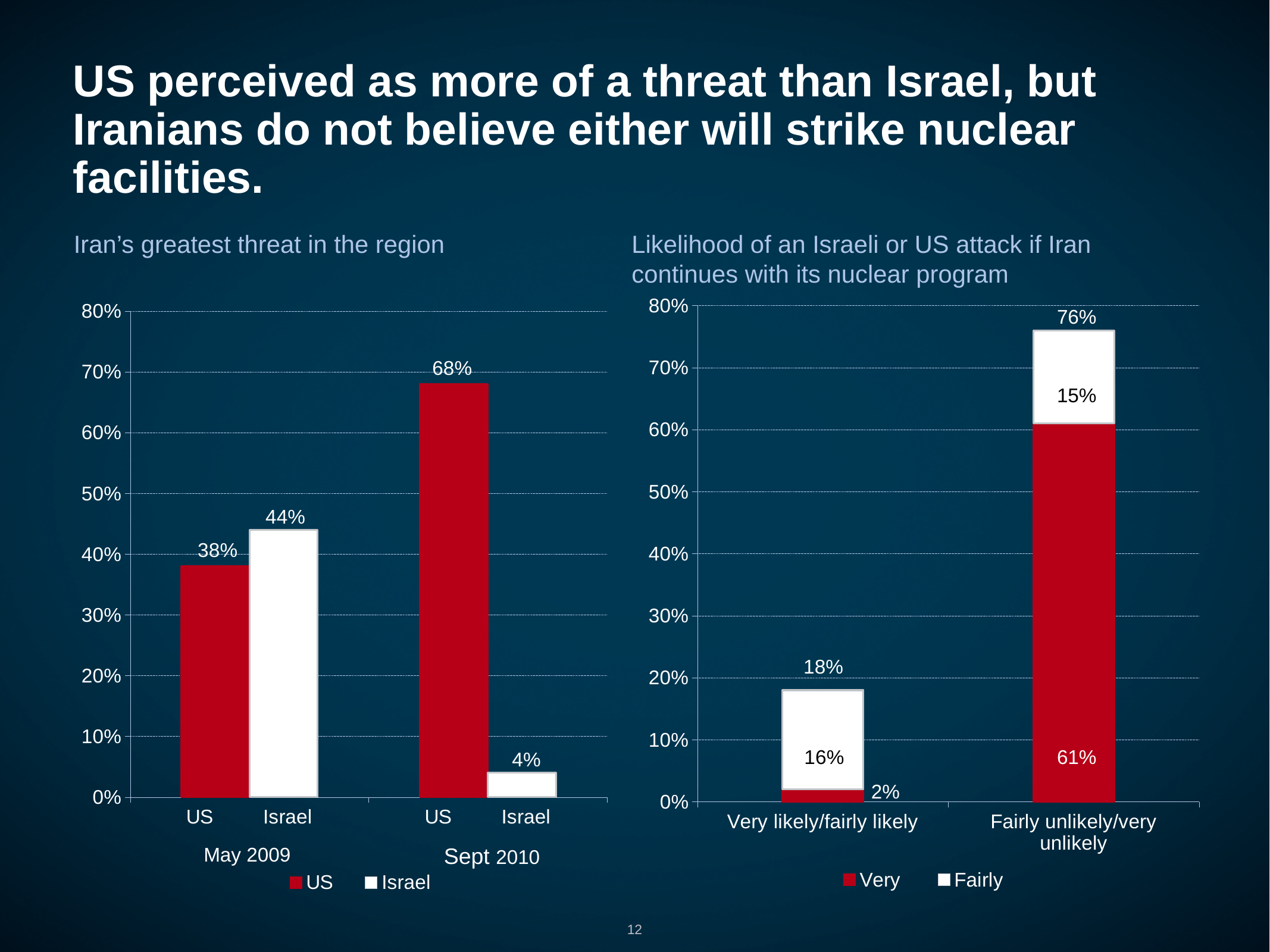
In the 'Likelihood of an Israeli or US attack' chart, what is the total of the 'Fairly unlikely/very unlikely' stacked bar? 76% In the 'Iran's greatest threat in the region' chart, what is the difference between the US value in Sept 2010 and the US value in May 2009? 30% In the 'Likelihood of an Israeli or US attack' chart, what is the 'Fairly' value for 'Very likely/fairly likely'? 16% In the 'Iran's greatest threat in the region' chart, what is the value for Israel in Sept 2010? 4% In the 'Iran's greatest threat in the region' chart, what is the value for US in May 2009? 38% In the 'Iran's greatest threat in the region' chart, which is larger in May 2009, US or Israel? Israel What kind of chart is the 'Likelihood of an Israeli or US attack' chart? Stacked bar chart In the 'Likelihood of an Israeli or US attack' chart, what is the difference between the totals of the two stacked bars? 58% In the 'Iran's greatest threat in the region' chart, which bar is the highest? US, Sept 2010 In the 'Iran's greatest threat in the region' chart, how many series does the legend list? 2 In the 'Likelihood of an Israeli or US attack' chart, what colour represents the 'Very' series? Red In the 'Likelihood of an Israeli or US attack' chart, what is the 'Very' value for 'Fairly unlikely/very unlikely'? 61%